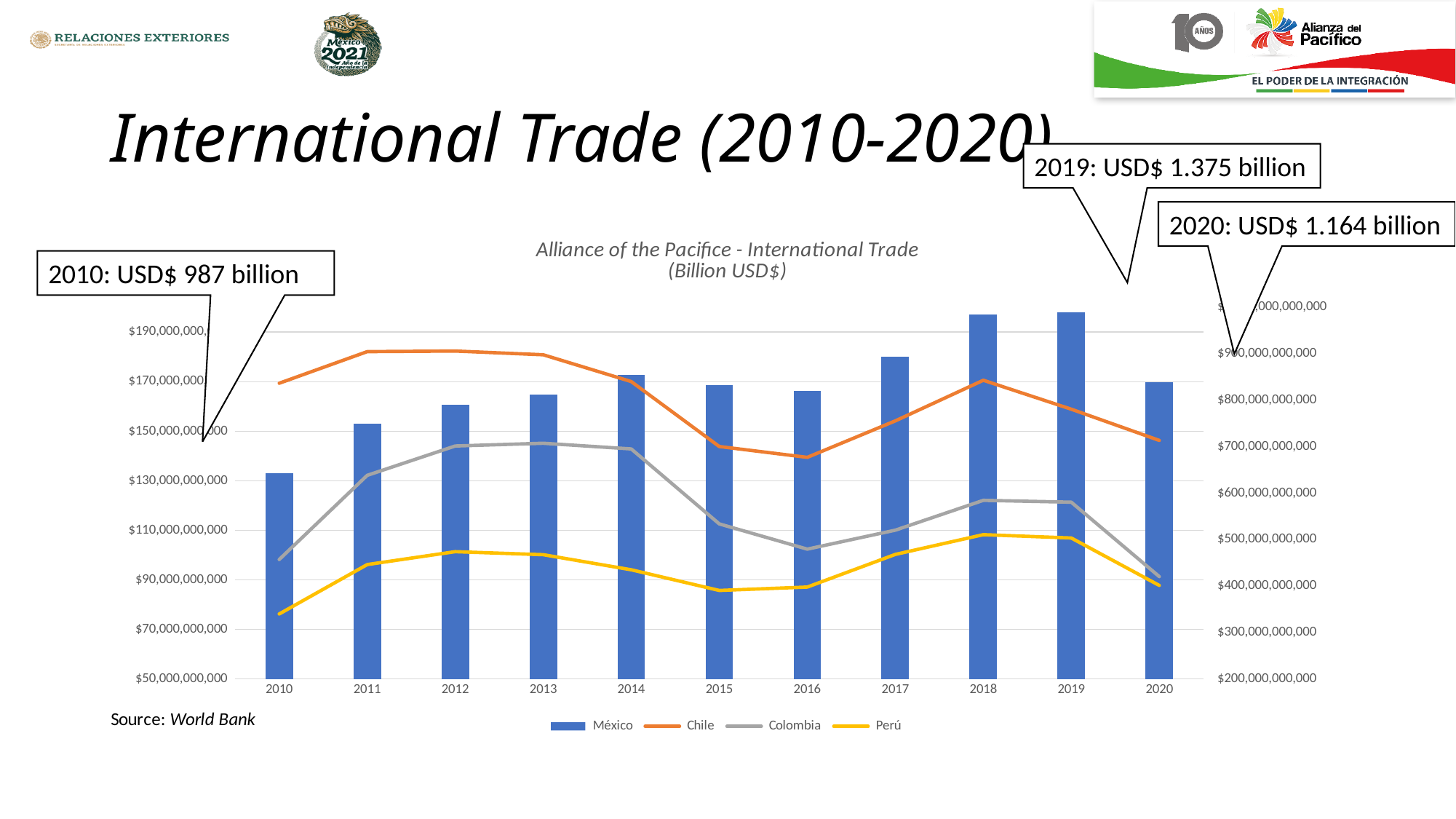
In which year is the Perú line lowest? 2010 Is the value for Chile in 2011 greater or less than $170,000,000,000? greater Which is higher in 2020, Chile or Colombia? Chile Does the Colombia line rise or fall from 2018 to 2020? Fall How many years are shown on the x axis? 11 What kind of chart is shown on the slide? A combination bar and line chart In which year is the Colombia line lowest? 2020 What value does the callout for 2019 give? USD$ 1.375 billion In which year is the México bar lowest? 2010 What is the title of the chart? Alliance of the Pacifice - International Trade (Billion USD$) Is the value for Perú in 2015 greater or less than $90,000,000,000? less How many series does the legend list? 4